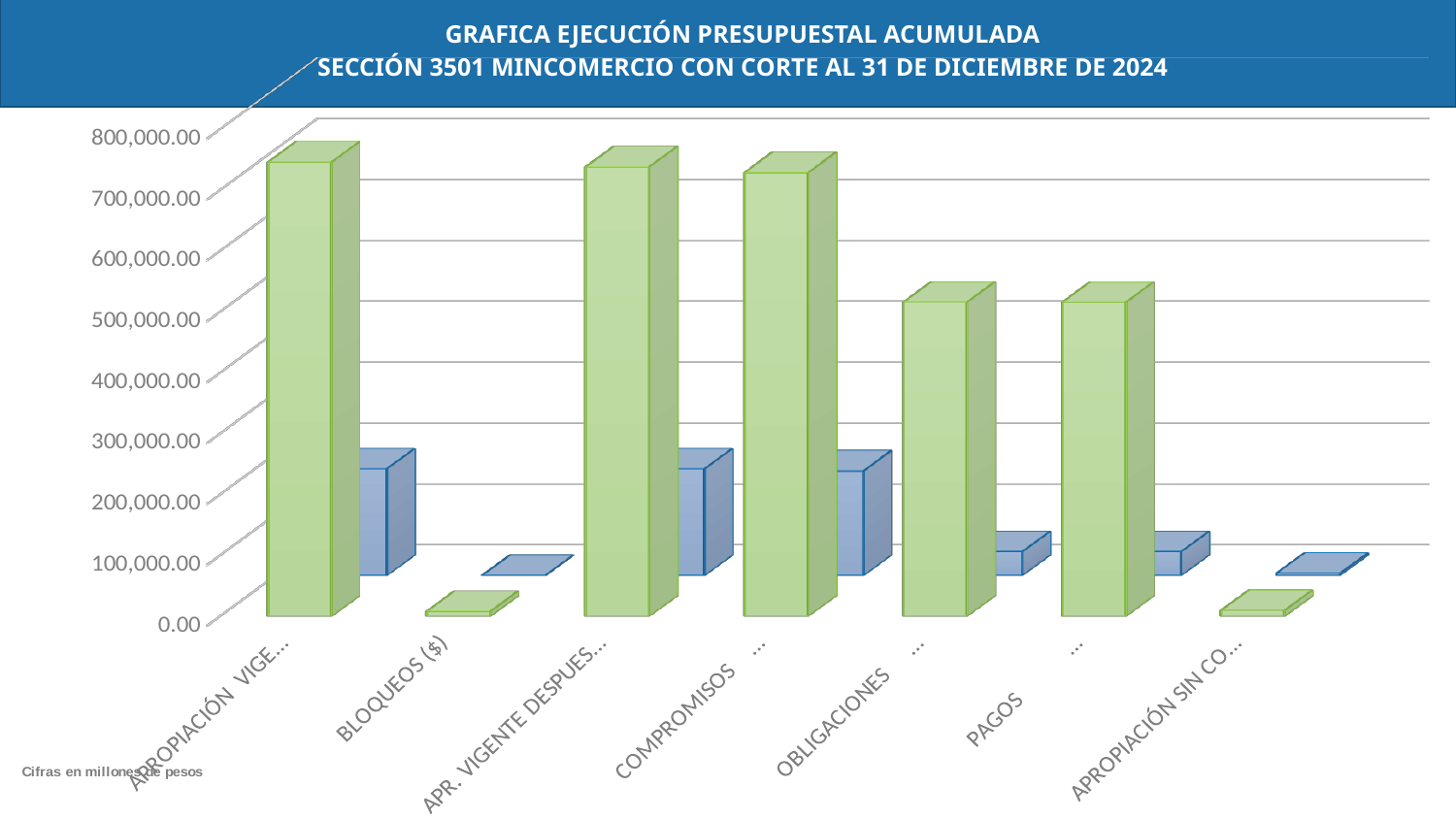
Is the green bar for APROPIACIÓN VIGE... greater or less than 600,000.00? greater Which green bar is larger, COMPROMISOS or OBLIGACIONES? COMPROMISOS Is the green bar for BLOQUEOS ($) greater or less than 100,000.00? less Is the green bar for PAGOS greater or less than 700,000.00? less According to the note at the bottom left of the slide, in what units are the figures expressed? millones de pesos Which green bar is larger, PAGOS or BLOQUEOS ($)? PAGOS How many categories are shown along the x axis of the chart? 7 What is the first line of the chart title? GRAFICA EJECUCIÓN PRESUPUESTAL ACUMULADA What kind of chart is shown on the slide? bar chart